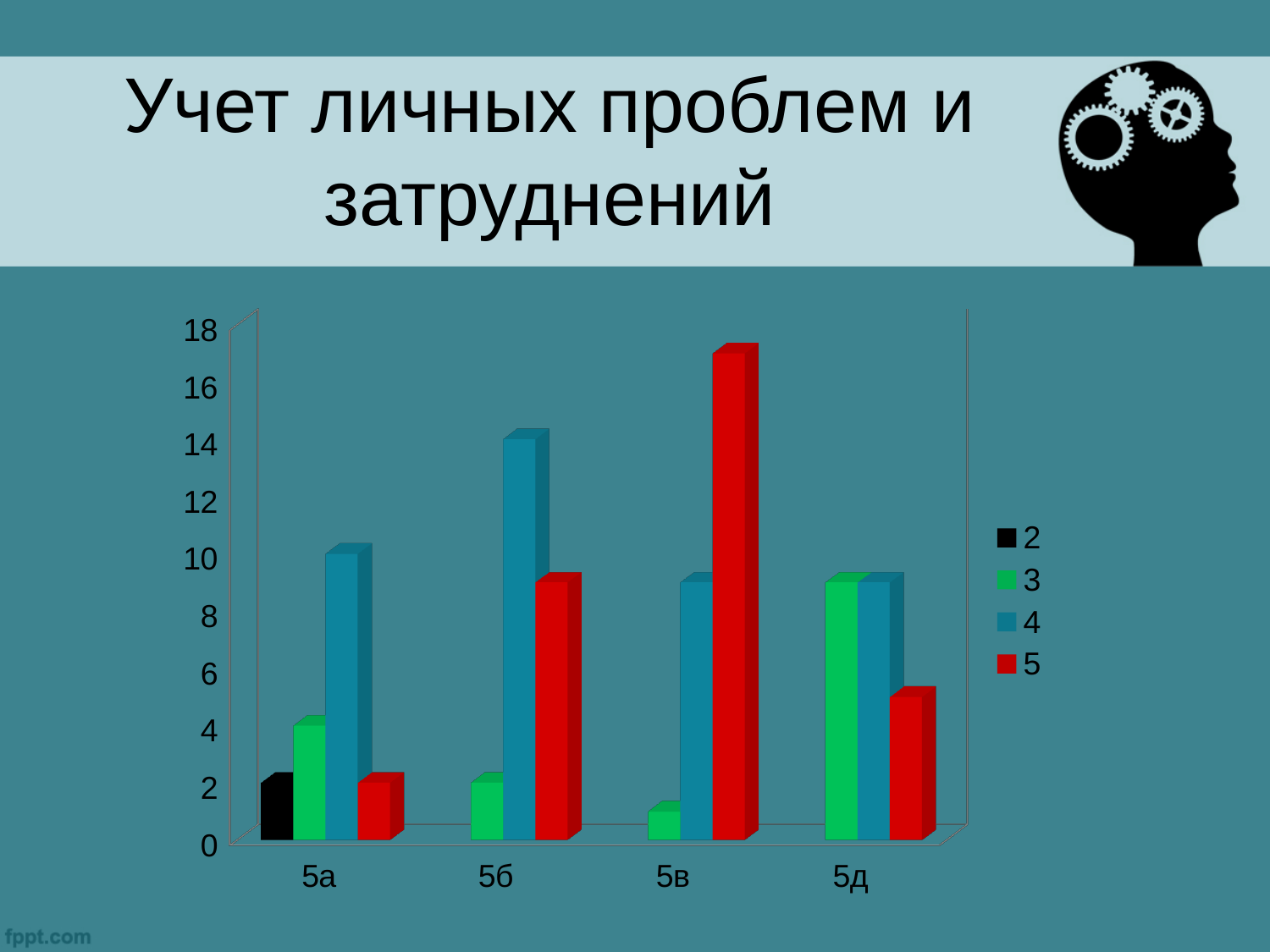
Is the value of series 5 for 5д greater or less than 8? less Which category has the tallest bar for series 5? 5в For category 5а, which is larger: series 4 or series 5? series 4 How many series does the legend list? 4 What colour are the bars for series 5 in the legend? red Is the value of series 5 for 5в greater or less than 16? greater What kind of chart is shown on the slide? bar chart How many categories are shown on the x axis of the chart? 4 Which category has the lowest bar for series 3? 5в Which category has a larger value for series 4: 5б or 5в? 5б Is the value of series 4 for 5б greater or less than 12? greater